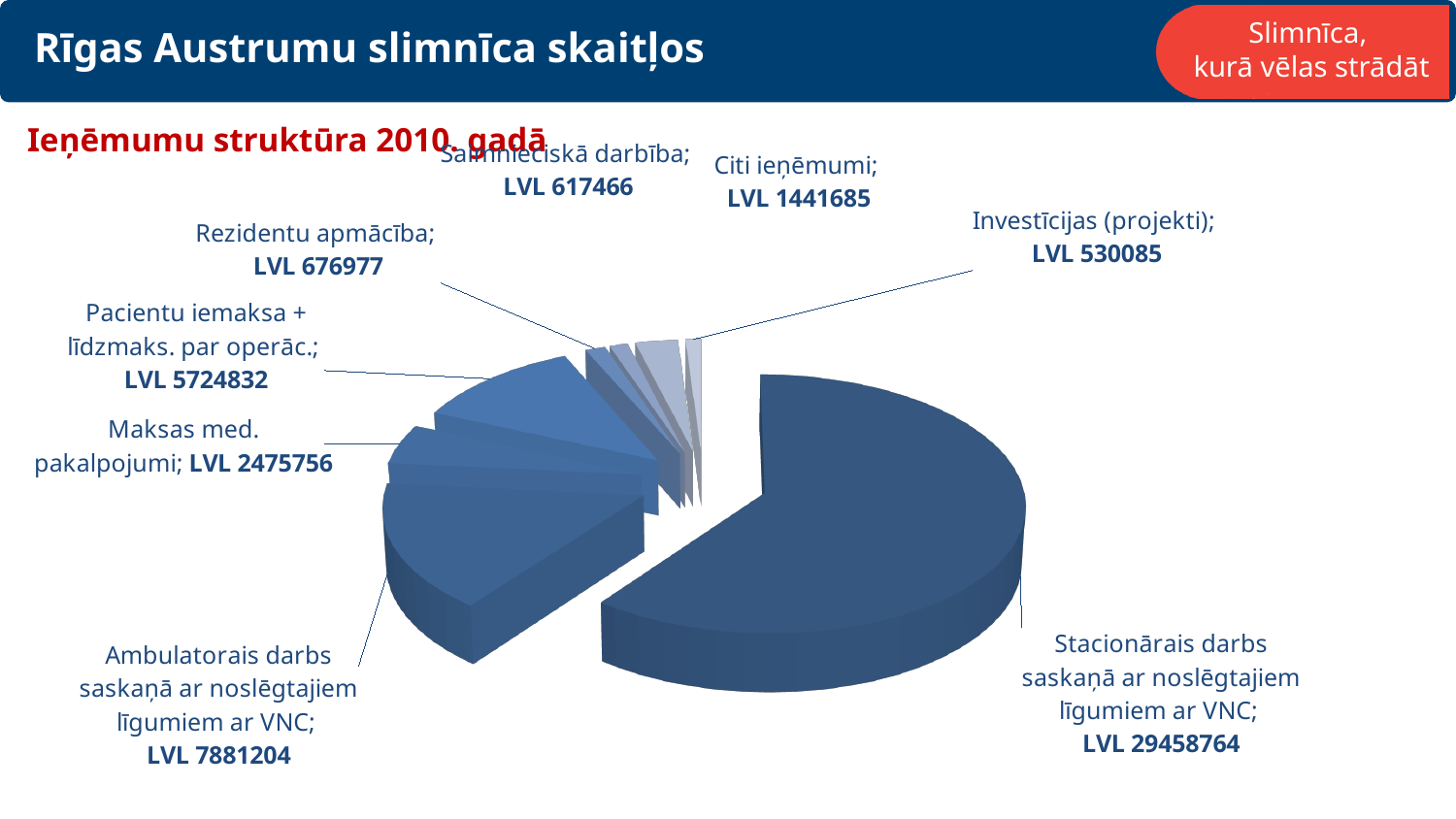
How many slices does the pie chart have? 8 Which category has the smallest value? Investīcijas (projekti) What is the value for Rezidentu apmācība? LVL 676977 What is the title of the chart? Ieņēmumu struktūra 2010. gadā Which is larger: Pacientu iemaksa + līdzmaks. par operāc. or Maksas med. pakalpojumi? Pacientu iemaksa + līdzmaks. par operāc. What is the difference between Ambulatorais darbs saskaņā ar noslēgtajiem līgumiem ar VNC and Maksas med. pakalpojumi? LVL 5405448 What is the value for Ambulatorais darbs saskaņā ar noslēgtajiem līgumiem ar VNC? LVL 7881204 What type of chart is shown on the slide? Pie chart Which category has the largest slice of the pie? Stacionārais darbs saskaņā ar noslēgtajiem līgumiem ar VNC What is the value for Stacionārais darbs saskaņā ar noslēgtajiem līgumiem ar VNC? LVL 29458764 What is the difference between Citi ieņēmumi and Investīcijas (projekti)? LVL 911600 What is the value for Citi ieņēmumi? LVL 1441685